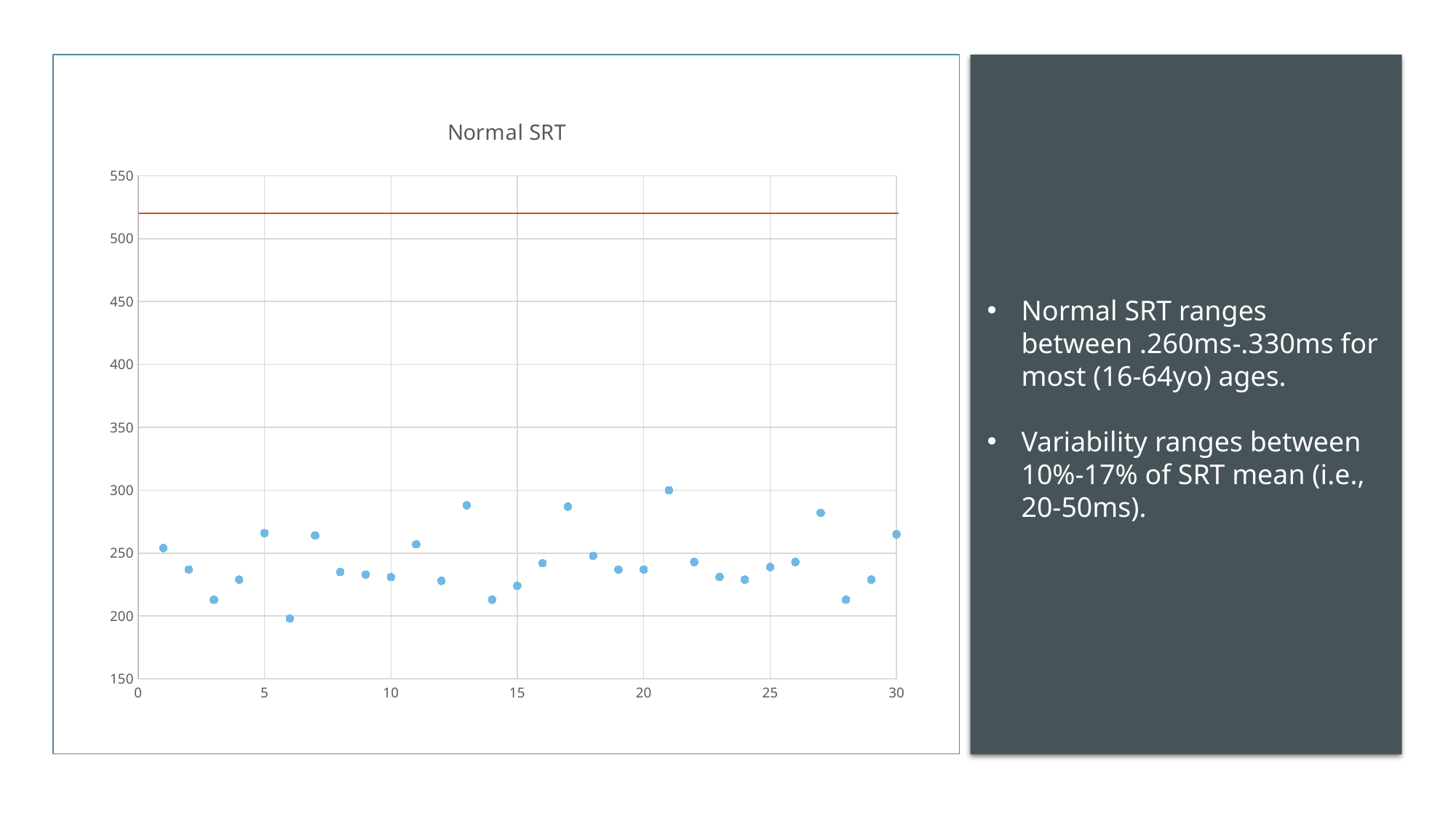
Is the value of the point at x = 6 greater or less than 250? less At which x value does the highest plotted point occur? 21 What is the highest value shown on the y axis? 550 Which point has the larger value, the one at x = 21 or the one at x = 6? x = 21 How many data points are plotted in the Normal SRT chart? 30 Is the value of the point at x = 3 greater or less than 250? less Is the value of the point at x = 21 greater or less than 250? greater What kind of chart is shown on the slide? scatter chart What is the title of the chart? Normal SRT At which x value does the lowest plotted point occur? 6